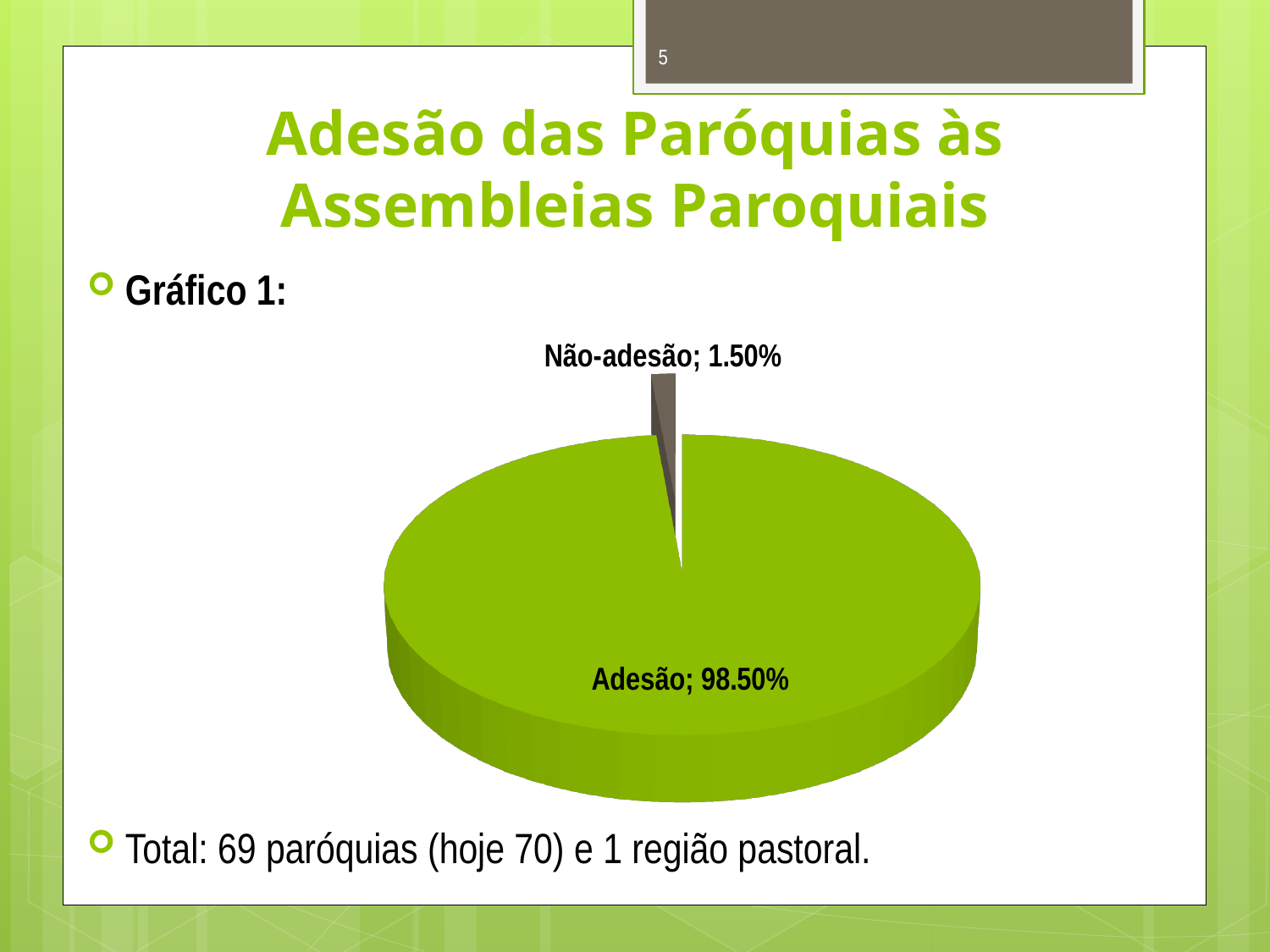
What colour is the Adesão slice? green How many slices does the pie chart have? 2 What share of the pie does Não-adesão represent? 1.50% What is the value for Não-adesão? 1.50% Which is larger, Adesão or Não-adesão? Adesão What is the value for Adesão? 98.50% Which slice is the smallest? Não-adesão Which slice is the largest? Adesão What kind of chart is shown on the slide? pie chart What is the difference between the Adesão and Não-adesão values? 97.00% What label is given to the chart on the slide? Gráfico 1